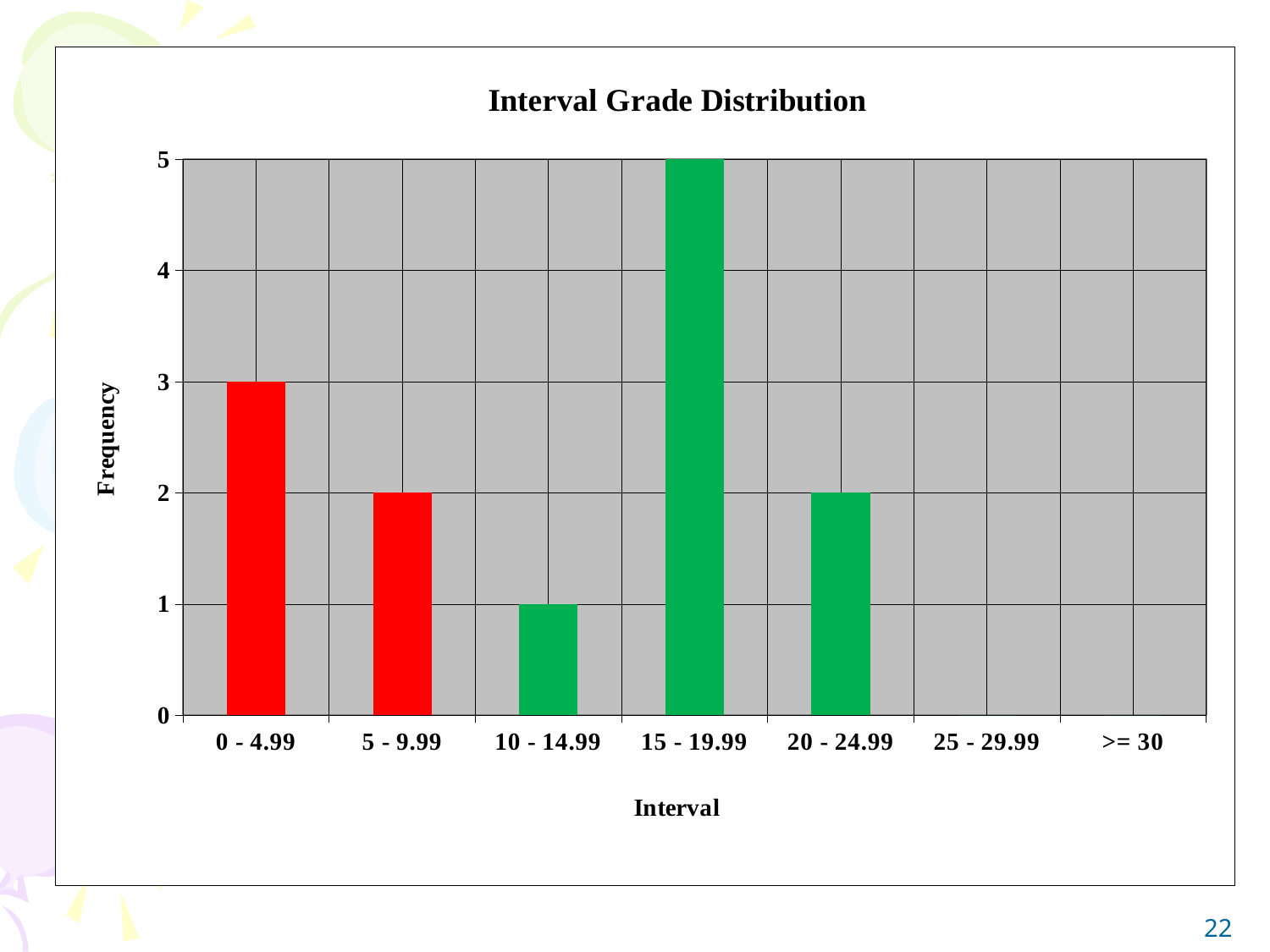
What is the difference in frequency between the 15 - 19.99 interval and the 0 - 4.99 interval? 2 What is the frequency for the 15 - 19.99 interval? 5 What kind of chart is shown on the slide? Bar chart What is the frequency for the 10 - 14.99 interval? 1 What is the title of the chart? Interval Grade Distribution Which interval has the highest frequency? 15 - 19.99 Among the intervals with a visible bar, which has the lowest frequency? 10 - 14.99 How many intervals are shown on the x axis? 7 Which interval has a higher frequency, 0 - 4.99 or 5 - 9.99? 0 - 4.99 What is the frequency for the 20 - 24.99 interval? 2 What is the frequency for the 0 - 4.99 interval? 3 What colour are the bars for the 0 - 4.99 and 5 - 9.99 intervals? Red